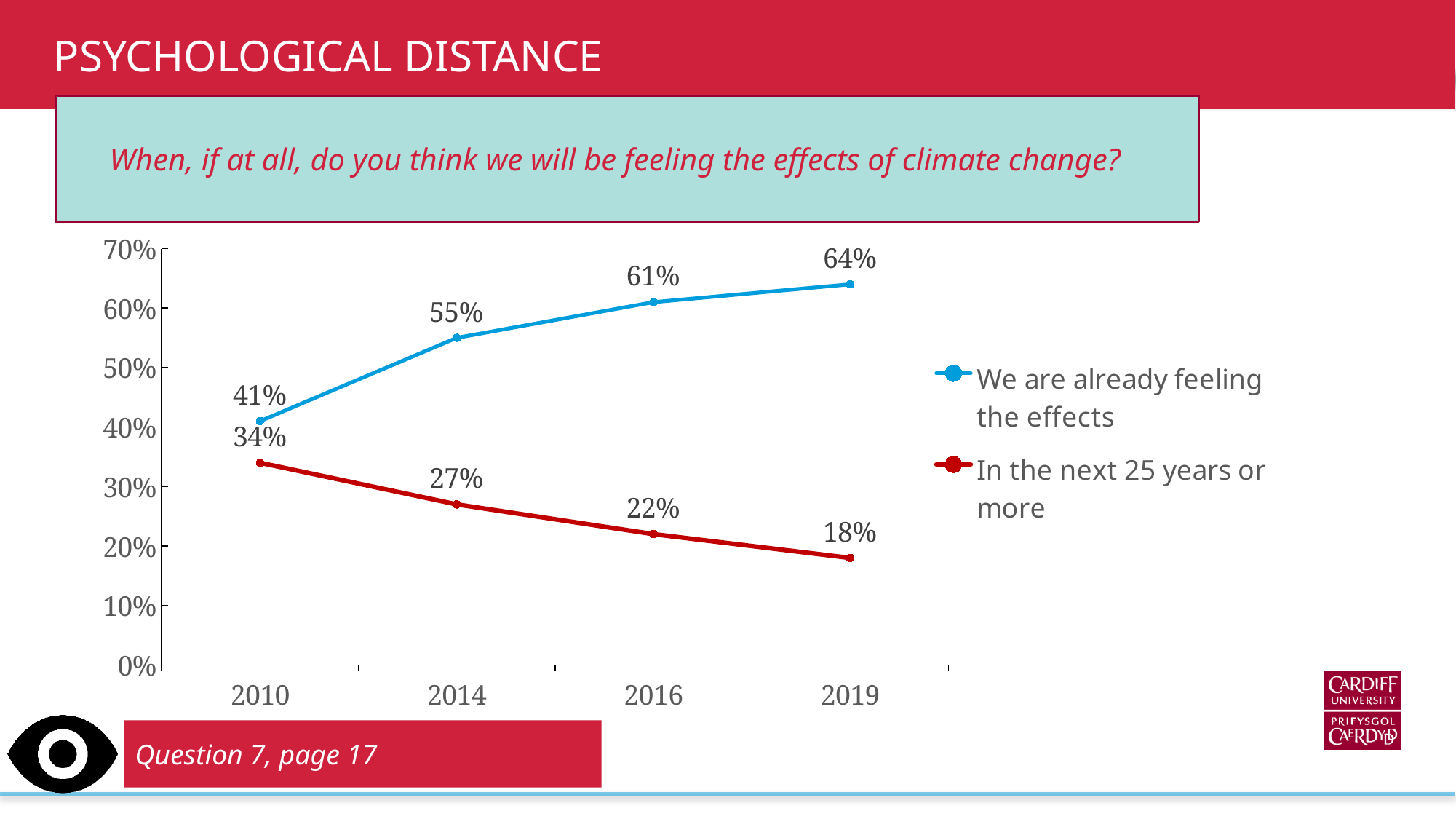
What percentage said "In the next 25 years or more" in 2019? 18% Which series has the larger value in 2014? We are already feeling the effects By how much did "We are already feeling the effects" increase from 2010 to 2014? 14 percentage points How many series does the legend list? 2 Does the "In the next 25 years or more" series rise or fall from 2010 to 2019? Fall What kind of chart is shown on the slide? Line chart What is the difference between the two series in 2019? 46 percentage points In which year is "In the next 25 years or more" lowest? 2019 What percentage said "We are already feeling the effects" in 2010? 41% In which year is "We are already feeling the effects" highest? 2019 What is the value for "We are already feeling the effects" in 2016? 61% How many years are shown on the x axis? 4